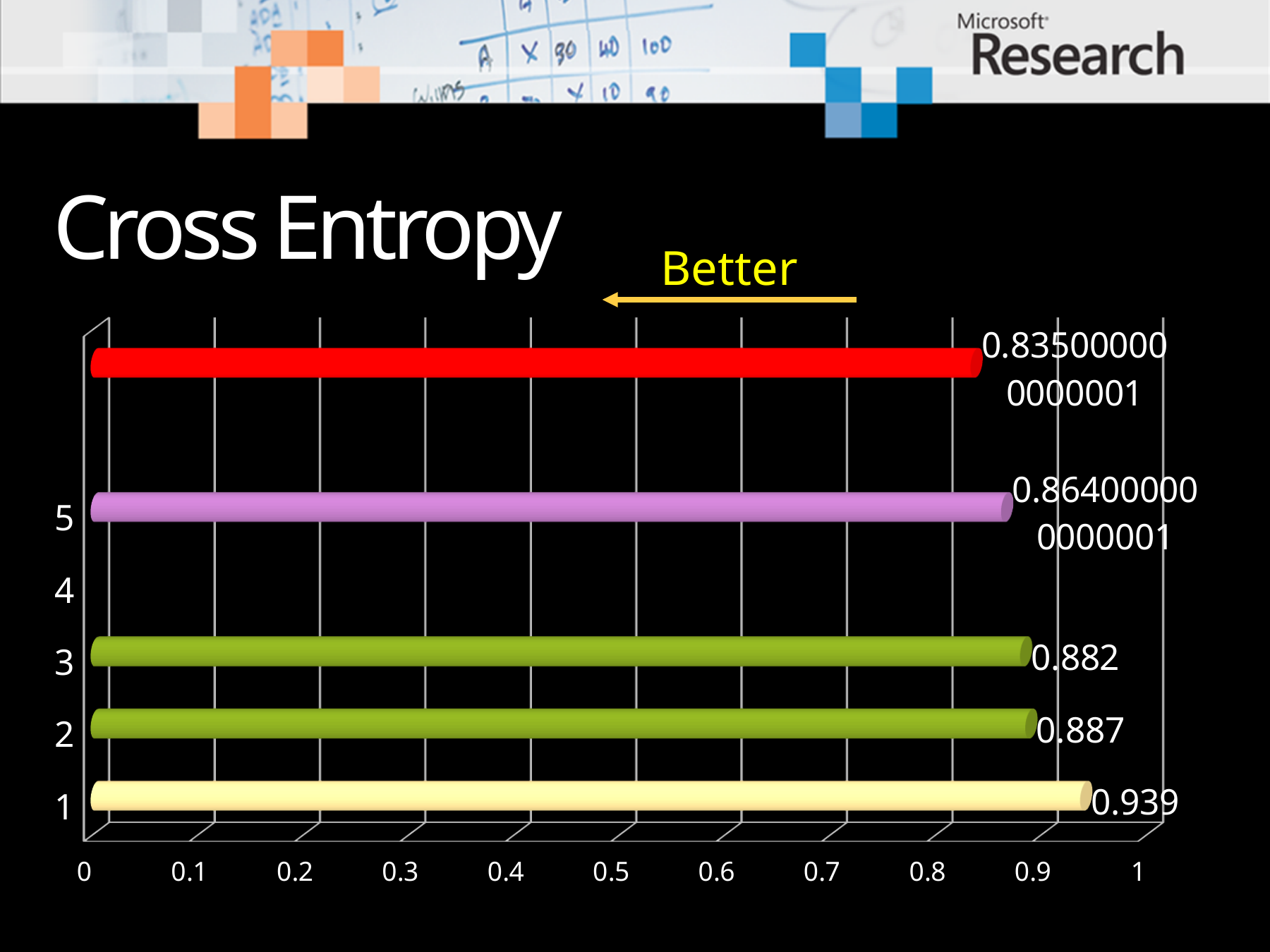
Is the value for category 1 greater or less than 0.9? greater Which category has the highest value? 1 What is the value for category 5? 0.8640000000000001 What is the difference between the values for category 2 and category 3? 0.005 What is the value for category 1? 0.939 What is the title of the chart? Cross Entropy Is the value for category 5 greater or less than 0.9? less Which is larger, the value for category 1 or the value for category 3? category 1 What is the difference between the values for category 1 and category 2? 0.052 What is the value for category 3? 0.882 What is the value for category 2? 0.887 What kind of chart is shown on the slide? bar chart